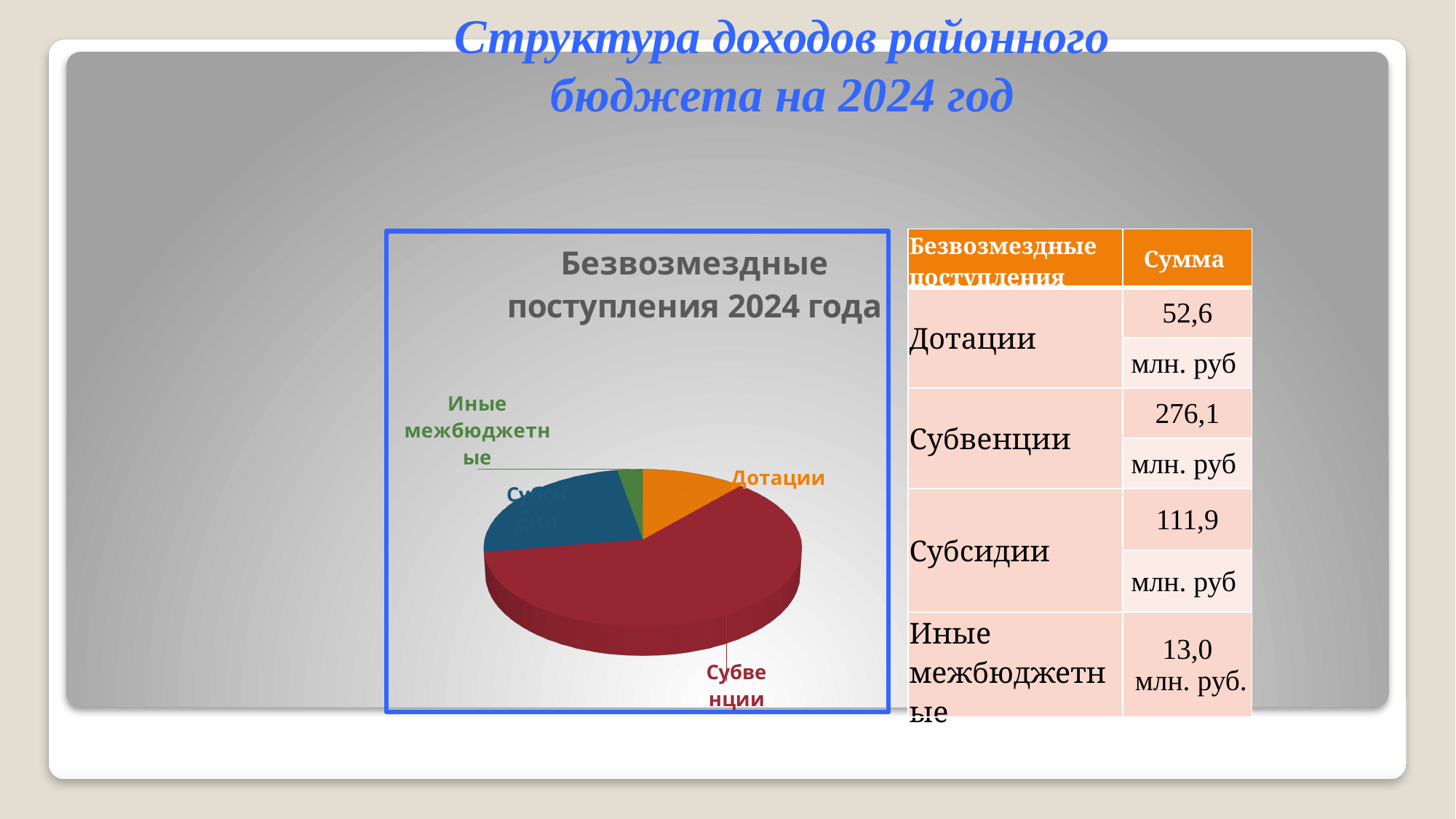
Which is larger, Субсидии or Дотации? Субсидии Which category has the smallest slice of the pie? Иные межбюджетные How many slices does the pie chart have? 4 What kind of chart is shown on the slide? Pie chart What colour is the Субвенции slice? Red What is the value for Дотации? 52,6 млн. руб What is the value for Субсидии? 111,9 млн. руб What is the difference between Субвенции and Субсидии? 164,2 млн. руб What is the value for Иные межбюджетные? 13,0 млн. руб. What is the value for Субвенции? 276,1 млн. руб Which category has the largest slice of the pie? Субвенции What is the title of the chart? Безвозмездные поступления 2024 года